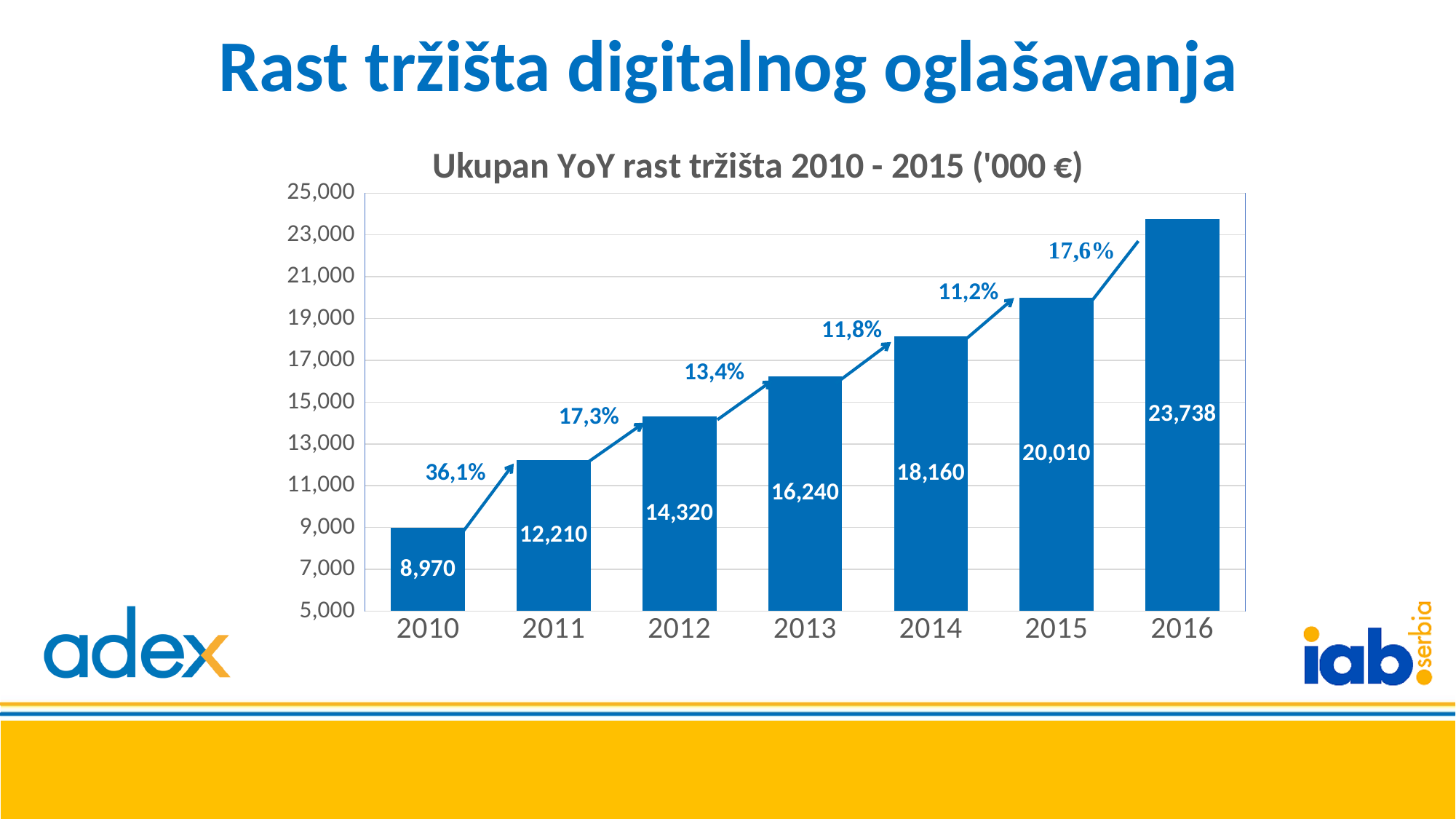
What is the value for 2010? 8,970 What is the value for 2016? 23,738 Which year has the highest value? 2016 What is the difference between the values for 2015 and 2014? 1,850 How many years are shown on the x axis? 7 Which is larger, the value for 2012 or the value for 2013? 2013 Do the values rise or fall from 2010 to 2016? rise What is the year-over-year growth percentage shown between 2015 and 2016? 17,6% What is the value for 2013? 16,240 Which year has the lowest value? 2010 What is the year-over-year growth percentage shown between 2010 and 2011? 36,1% What kind of chart is this? bar chart